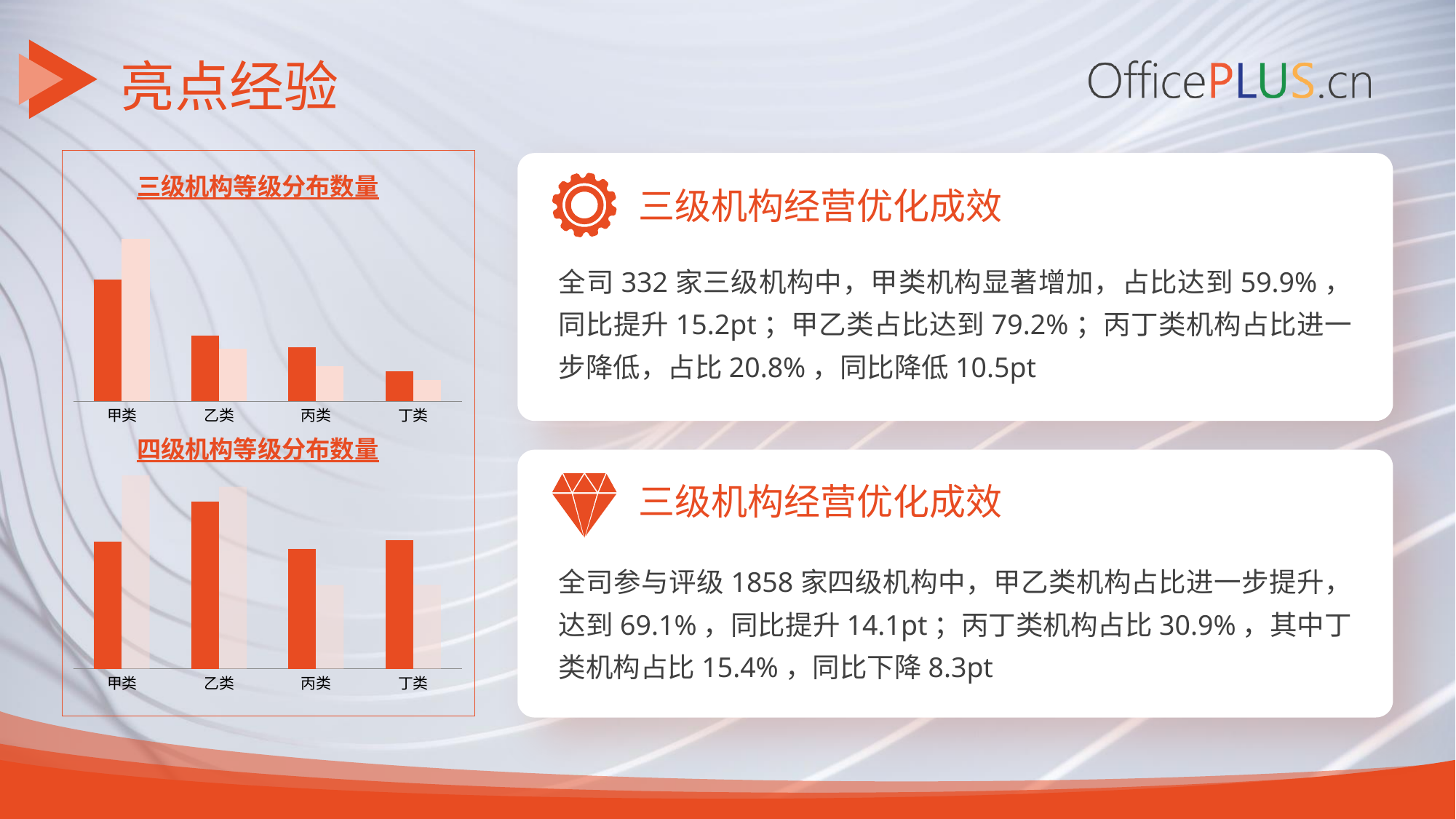
How many bars are plotted for each category in the bottom chart (四级机构等级分布数量)? 2 In the top chart (三级机构等级分布数量), which category has the shortest dark orange bar? 丁类 In the bottom chart (四级机构等级分布数量), which category has the tallest dark orange bar? 乙类 In the bottom chart (四级机构等级分布数量), which category has the shortest dark orange bar? 丙类 In the top chart (三级机构等级分布数量), for 甲类, which bar is taller: the dark orange bar or the light pink bar? the light pink bar In the top chart (三级机构等级分布数量), do the dark orange bars rise or fall from 甲类 to 丁类? fall What kind of chart is the top chart titled 三级机构等级分布数量? bar chart In the bottom chart (四级机构等级分布数量), which category has the tallest light pink bar? 甲类 What is the title of the bottom chart on the slide? 四级机构等级分布数量 In the top chart (三级机构等级分布数量), which category has the tallest dark orange bar? 甲类 How many categories are shown on the x axis of the top chart (三级机构等级分布数量)? 4 In the bottom chart (四级机构等级分布数量), for 丙类, which bar is taller: the dark orange bar or the light pink bar? the dark orange bar